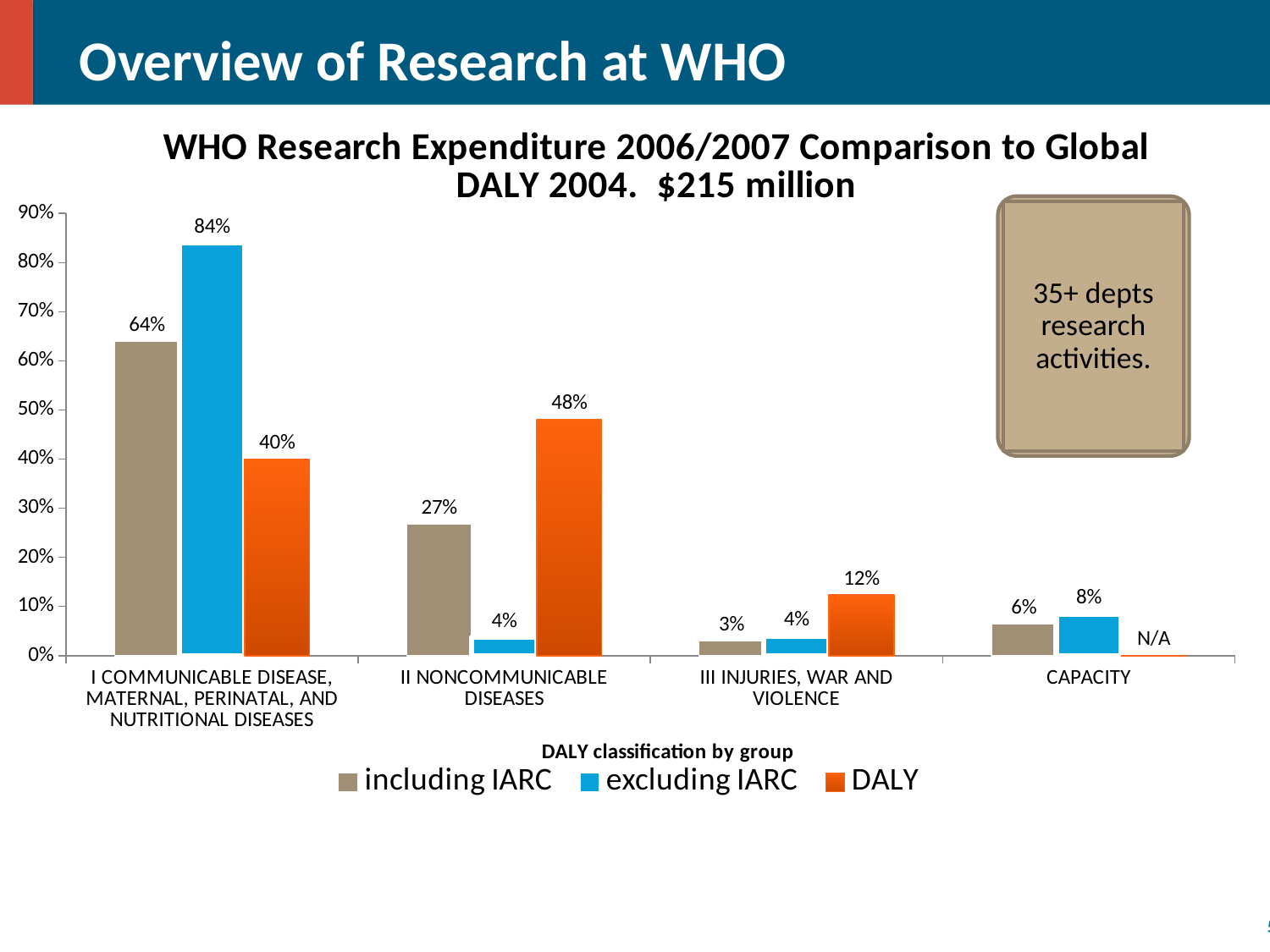
How many series does the legend list? 3 What is the difference between the 'excluding IARC' and DALY values for I Communicable Disease, Maternal, Perinatal, and Nutritional Diseases? 44% What is the DALY value for II Noncommunicable Diseases? 48% Which category has the highest 'including IARC' value? I Communicable Disease, Maternal, Perinatal, and Nutritional Diseases What is the 'excluding IARC' value for I Communicable Disease, Maternal, Perinatal, and Nutritional Diseases? 84% What is the 'including IARC' value for III Injuries, War and Violence? 3% For II Noncommunicable Diseases, which is larger: the 'including IARC' value or the DALY value? DALY What is the x-axis title of the chart? DALY classification by group What kind of chart is this? Bar chart What is shown as the DALY value for Capacity? N/A How many categories are shown on the x axis? 4